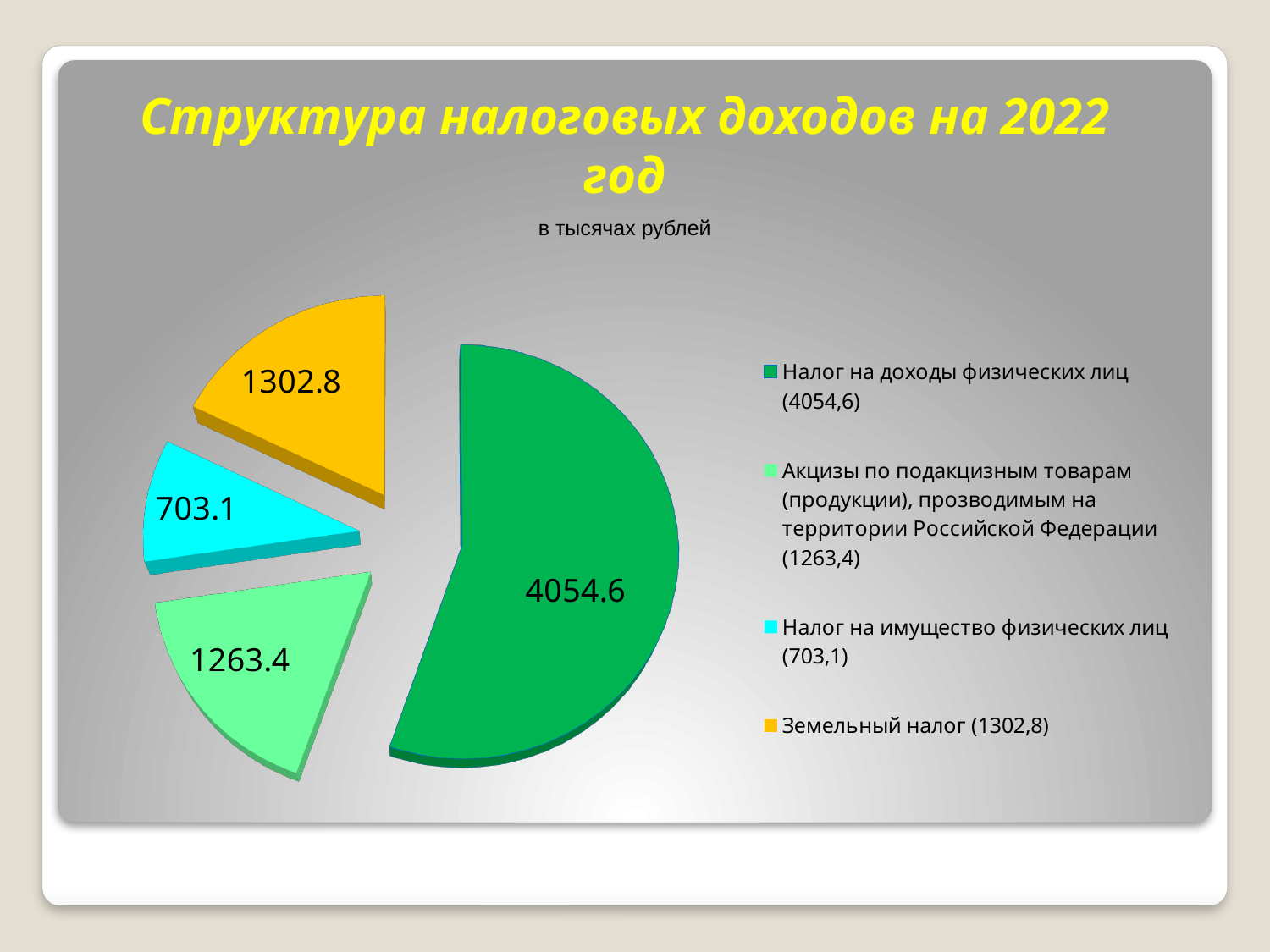
Which category has the smallest slice of the pie? Налог на имущество физических лиц What type of chart is shown on the slide? pie chart What is the difference between the values for Земельный налог and Акцизы по подакцизным товарам? 39.4 What is the value for Налог на доходы физических лиц? 4054.6 What is the value for Акцизы по подакцизным товарам (продукции), прозводимым на территории Российской Федерации? 1263.4 What is the title of the chart on the slide? Структура налоговых доходов на 2022 год What is the value for Земельный налог? 1302.8 Which is larger: the value for Земельный налог or the value for Акцизы по подакцизным товарам? Земельный налог Which category has the largest slice of the pie? Налог на доходы физических лиц What is the difference between the values for Налог на доходы физических лиц and Налог на имущество физических лиц? 3351.5 How many categories does the pie chart have? 4 What is the value for Налог на имущество физических лиц? 703.1